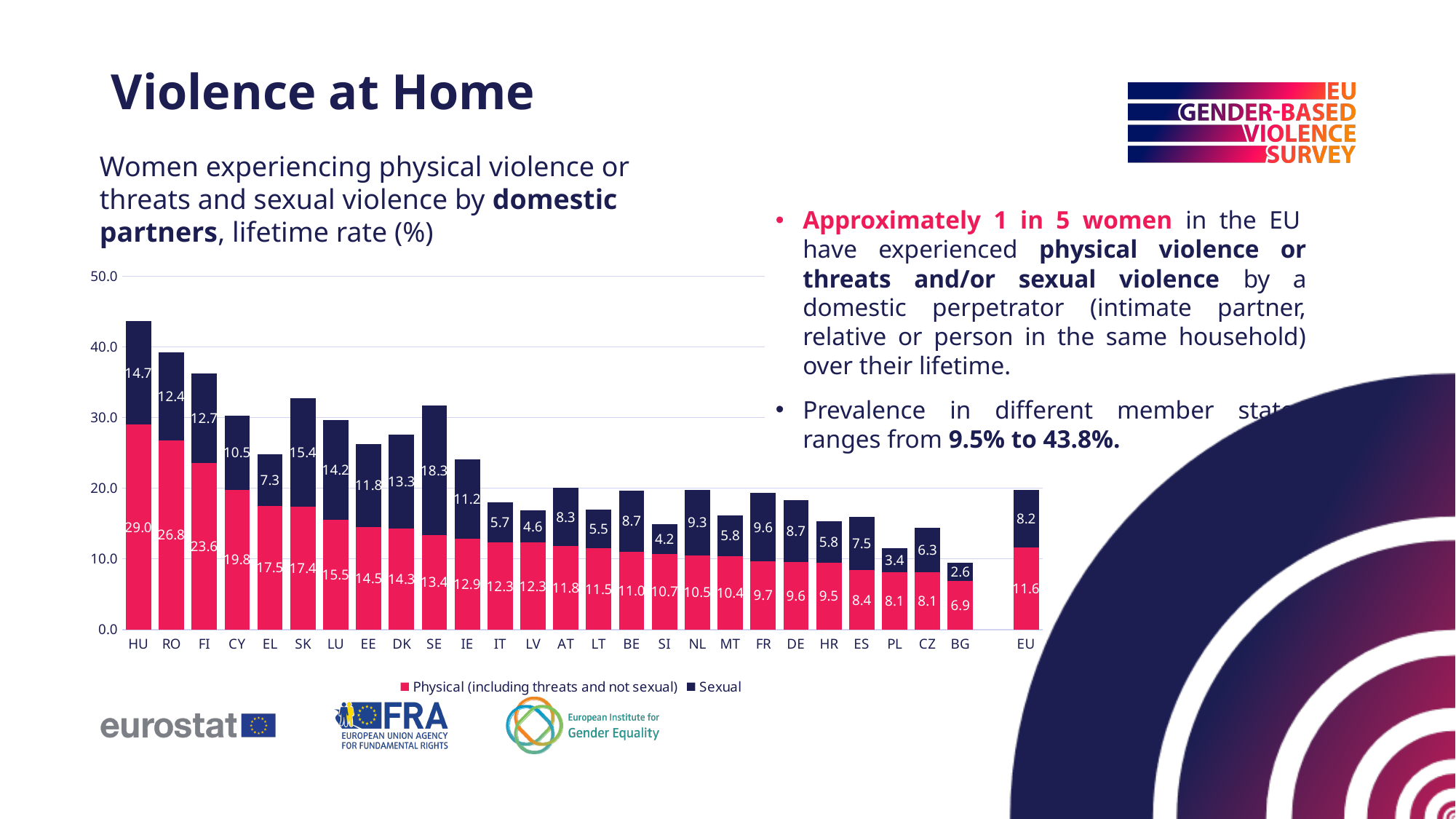
What is the Sexual value for SE? 18.3 How many series does the chart legend list? 2 Which country has the lowest Physical (including threats and not sexual) value? BG What is the Sexual value for the EU bar? 8.2 What is the difference between the Physical values for HU and RO? 2.2 What is the Physical (including threats and not sexual) value for HU? 29.0 Which has the larger Sexual value, SK or LU? SK Is the total height of the HU bar greater or less than 40.0? greater What is the total of the stacked bar for BG? 9.5 What kind of chart is shown on the slide? Stacked bar chart How many bars are plotted on the chart? 27 Which country has the highest Sexual value? SE